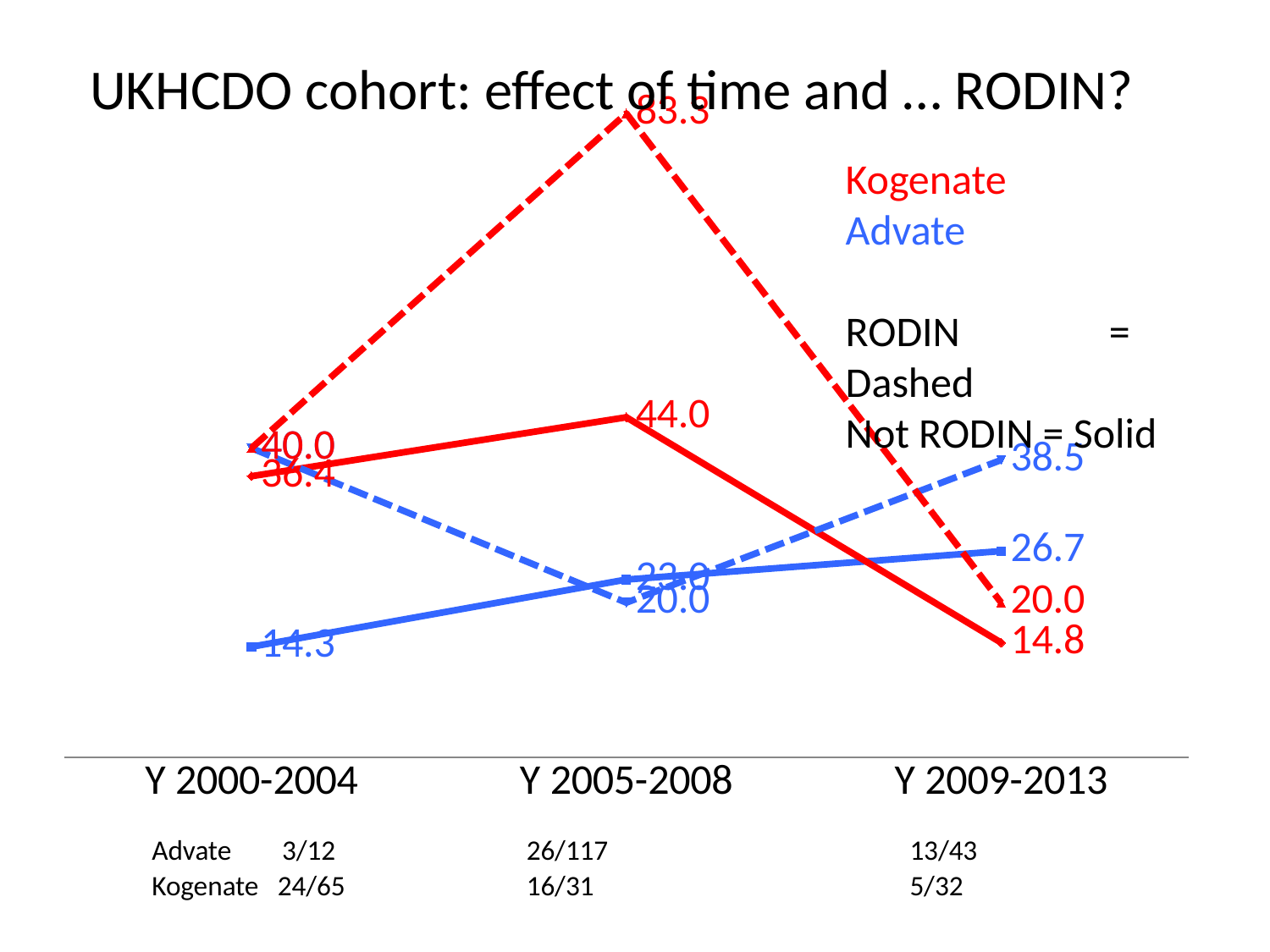
What is the value for the Kogenate RODIN (dashed) line in Y 2005-2008? 83.3 How many time periods are shown on the x axis? 3 What is the lowest value labelled on the chart? 14.3 Which line reaches the highest value on the chart, and in which period? Kogenate RODIN (dashed), Y 2005-2008 What is the value for the Advate Not RODIN (solid) line in Y 2000-2004? 14.3 What is the value for the Kogenate Not RODIN (solid) line in Y 2005-2008? 44.0 Does the Advate Not RODIN (solid) line rise or fall from Y 2000-2004 to Y 2009-2013? Rises What is the value for the Advate RODIN (dashed) line in Y 2009-2013? 38.5 What is the value for the Kogenate Not RODIN (solid) line in Y 2009-2013? 14.8 What kind of chart is shown on the slide? Line chart What is the difference between the Kogenate RODIN (dashed) and Kogenate Not RODIN (solid) values in Y 2005-2008? 39.3 In Y 2009-2013, which Kogenate line has the larger value, the dashed (RODIN) or the solid (Not RODIN)? Dashed (RODIN), 20.0